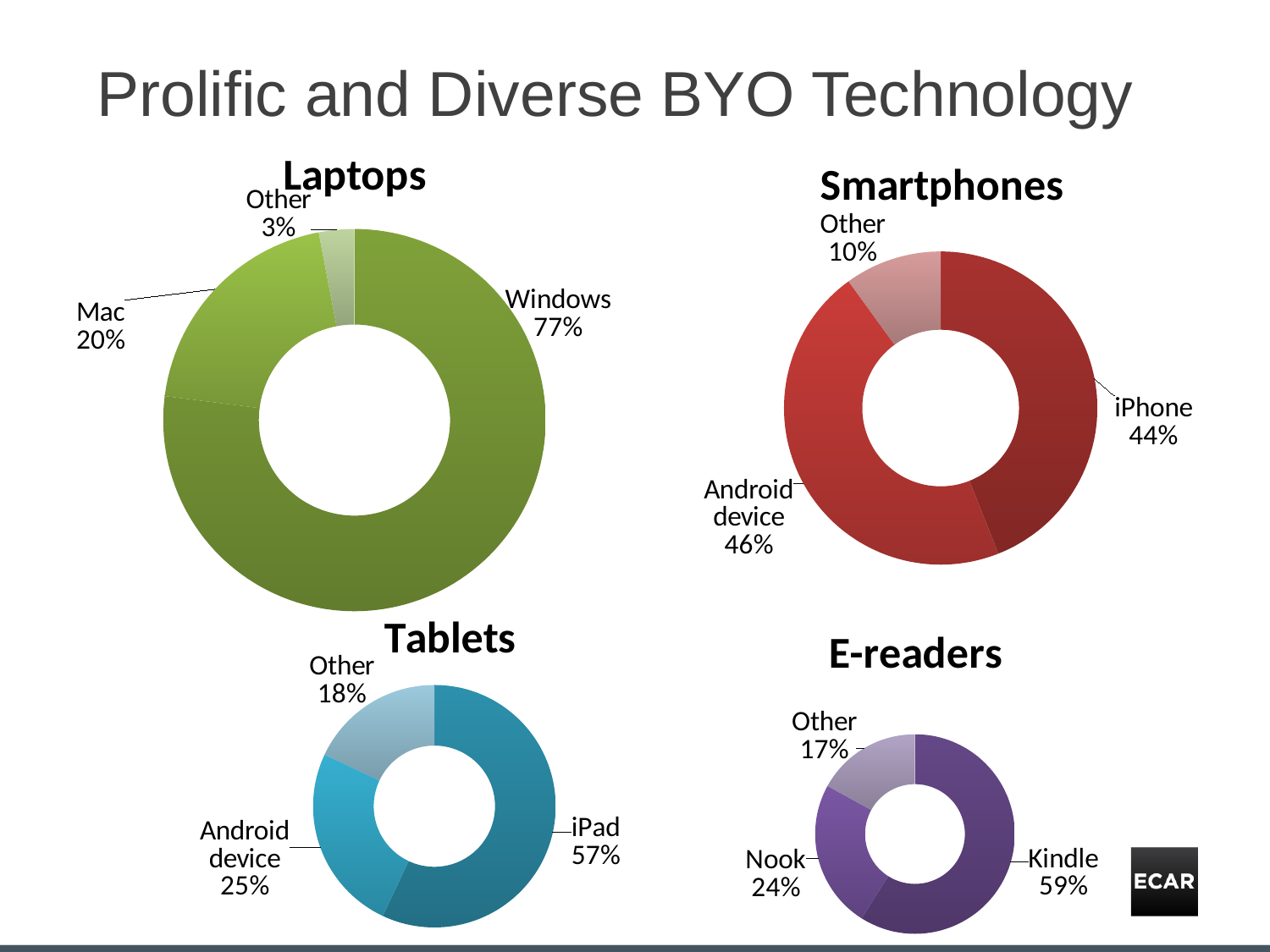
What kind of chart is the Tablets chart? Doughnut chart In the Smartphones chart, what percentage is shown for Android device? 46% In the Tablets chart, what is the difference between the iPad share and the Android device share? 32% How many charts are on the slide? 4 In the Smartphones chart, which is larger, the iPhone share or the Other share? iPhone In the Laptops chart, what percentage is shown for Windows? 77% In the Tablets chart, what percentage is shown for Other? 18% In the E-readers chart, which category has the largest share? Kindle In the Laptops chart, which category has the smallest share? Other How many categories does the Smartphones chart show? 3 In the Laptops chart, what is the difference between the Windows share and the Mac share? 57% In the E-readers chart, what percentage is shown for Nook? 24%